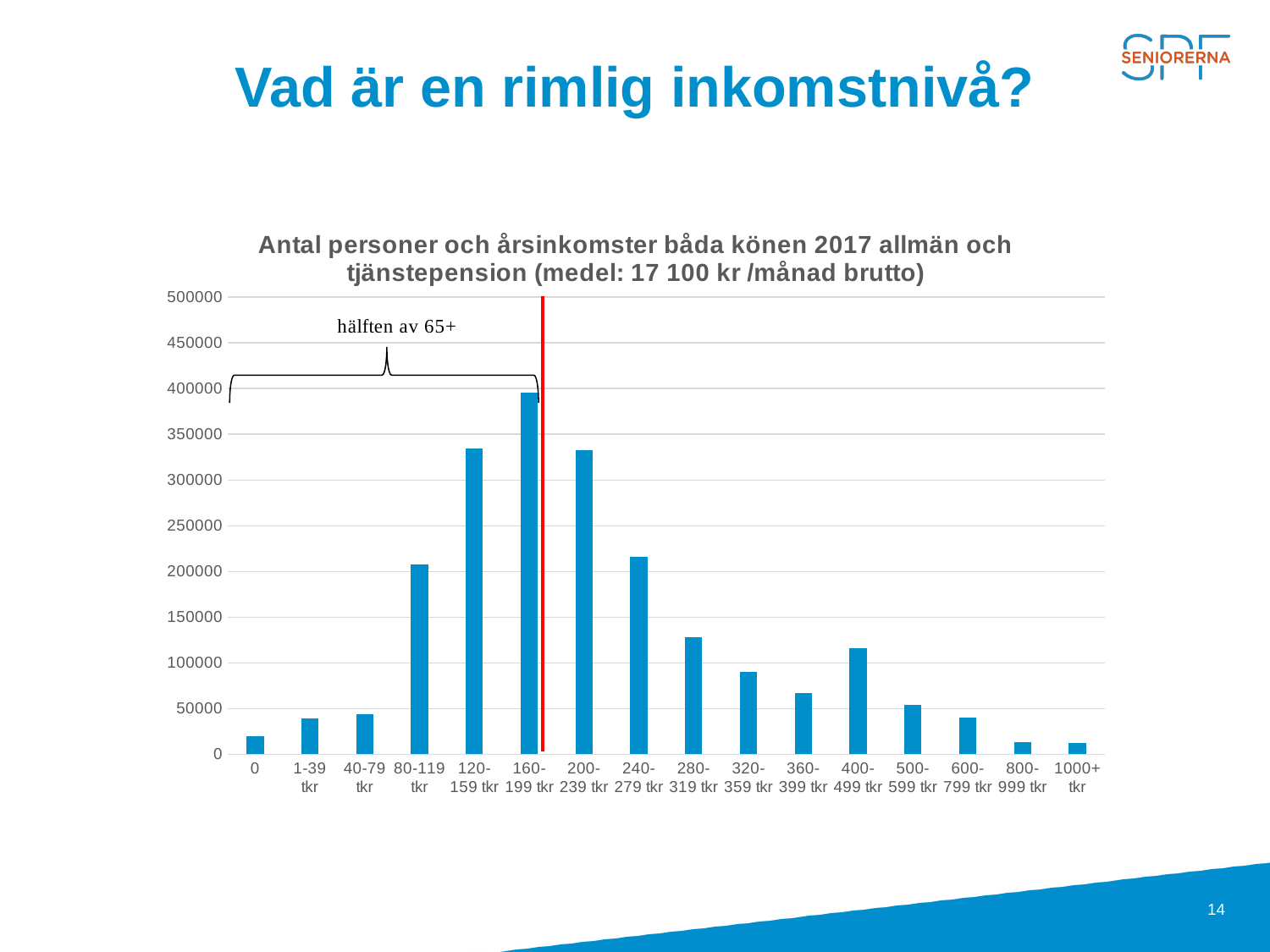
How many income categories are shown on the x axis of the chart? 16 Which income category has the highest number of persons? 160-199 tkr Is the value for the 160-199 tkr category greater or less than 350000? greater Which has more persons: the 320-359 tkr category or the 400-499 tkr category? 400-499 tkr Is the value for the 80-119 tkr category greater or less than 200000? greater Is the value for the 0 category greater or less than 50000? less What is the title of the chart? Antal personer och årsinkomster båda könen 2017 allmän och tjänstepension (medel: 17 100 kr /månad brutto) Which has more persons: the 160-199 tkr category or the 240-279 tkr category? 160-199 tkr What kind of chart is shown on the slide? Bar chart What text is written above the bracket spanning the leftmost bars of the chart? hälften av 65+